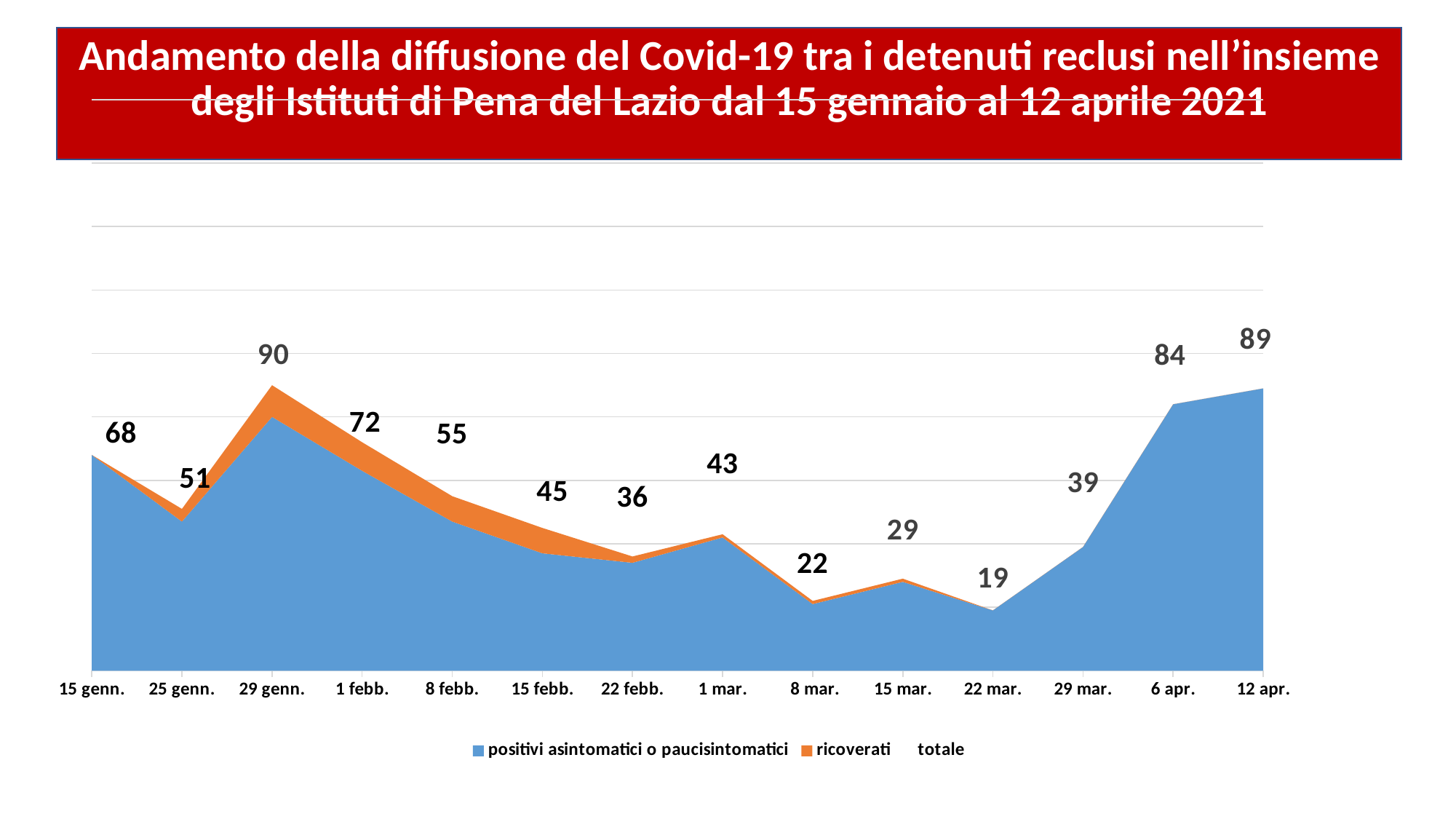
What kind of chart is shown on the slide? Area chart Which date has a larger total value, 15 febb. or 22 febb.? 15 febb. What is the total value shown for 22 mar.? 19 How many dates are shown on the x axis? 14 What is the total value shown for 1 mar.? 43 What is the total (totale) value shown for 29 genn.? 90 How many series does the legend list? 3 What is the difference between the total values for 29 genn. and 25 genn.? 39 On which date is the total value lowest? 22 mar. On which date is the total value highest? 29 genn. What is the total value shown for 12 apr.? 89 What is the difference between the total values for 12 apr. and 6 apr.? 5